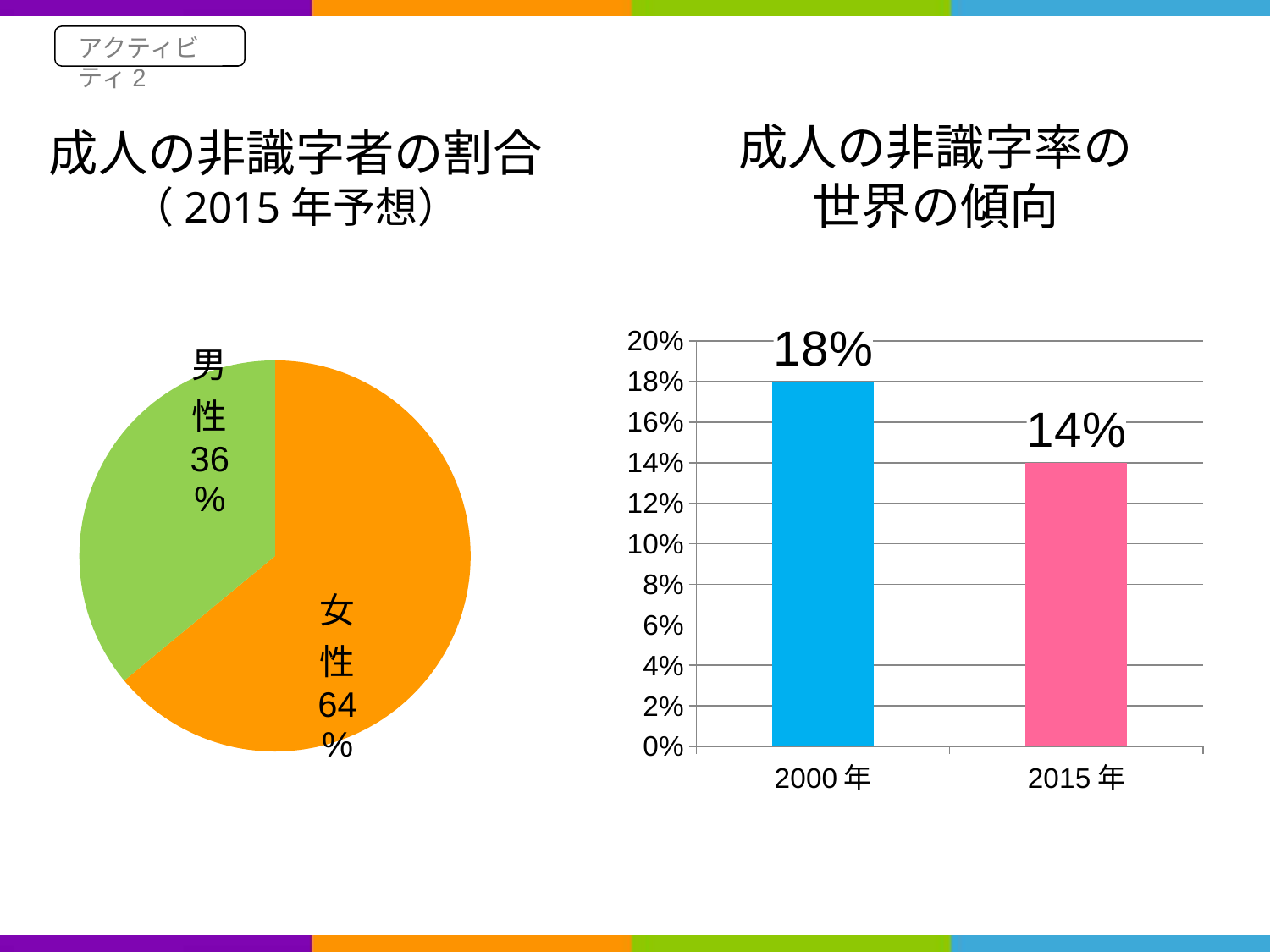
In the pie chart on the left (成人の非識字者の割合), what share is labelled for 女性? 64% In the bar chart on the right, do the values rise or fall from 2000年 to 2015年? Fall What kind of chart is the chart on the left of the slide? Pie chart In the bar chart on the right (成人の非識字率の世界の傾向), what is the value for 2000年? 18% In the pie chart on the left, which slice is larger, 男性 or 女性? 女性 In the pie chart on the left, what is the difference between the 女性 and 男性 shares? 28% How many slices does the pie chart on the left have? 2 In the bar chart on the right (成人の非識字率の世界の傾向), what is the value for 2015年? 14% What kind of chart is the chart on the right of the slide? Bar chart In the bar chart on the right, what is the difference between the 2000年 and 2015年 values? 4% In the bar chart on the right, which year has the higher value? 2000年 In the pie chart on the left (成人の非識字者の割合), what share is labelled for 男性? 36%